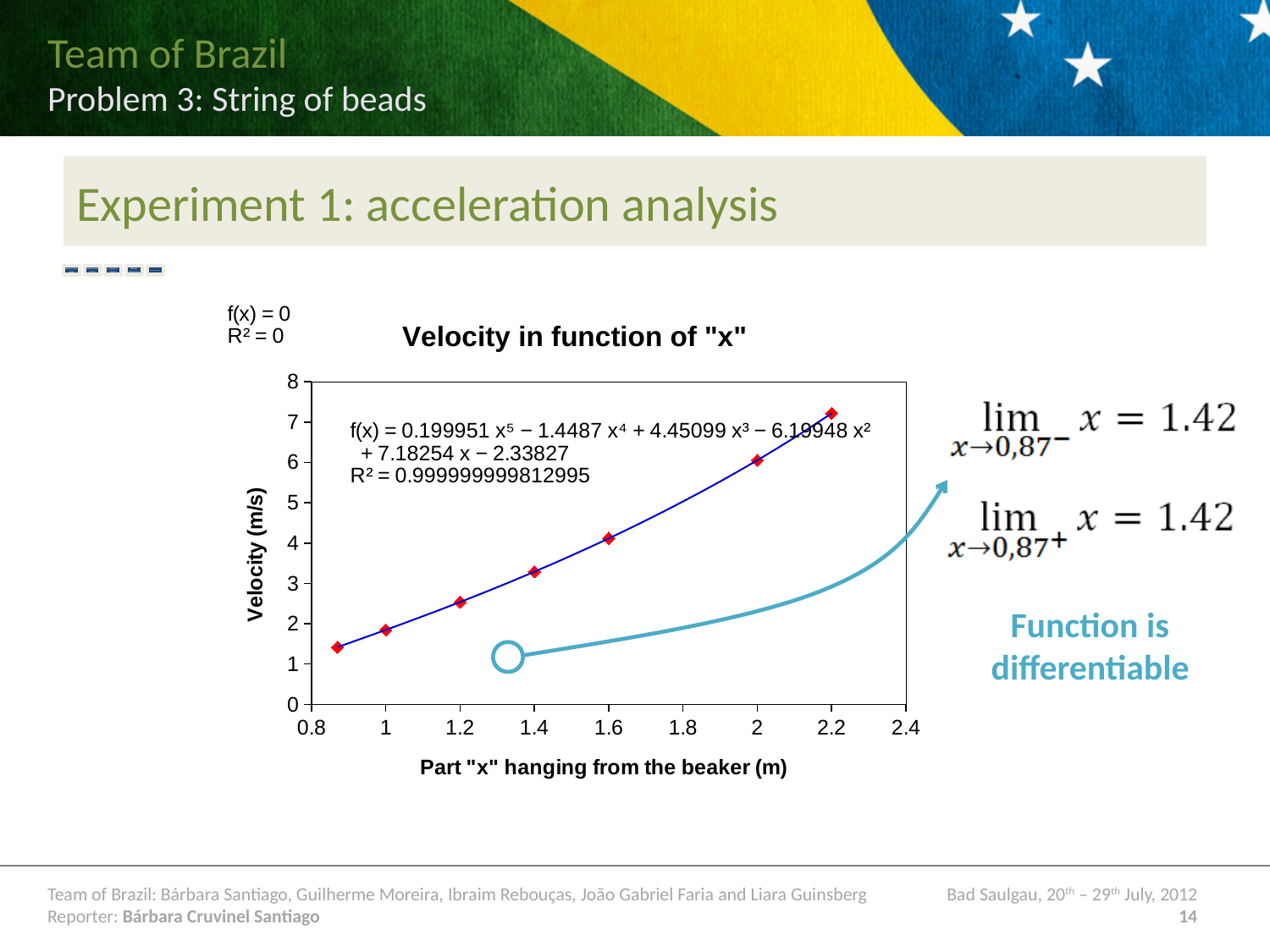
Is the velocity at x = 1.4 greater or less than 3 m/s? greater Which has the larger velocity: the point at x = 2 or the point at x = 1.6? x = 2 Is the velocity at x = 2.2 greater or less than 6 m/s? greater Is the velocity at x = 2 greater or less than 5 m/s? greater What is the title of the chart? Velocity in function of "x" Does velocity rise or fall as the part "x" hanging from the beaker increases? rise What kind of chart is shown on the slide? scatter chart with a fitted curve At which x value is the plotted velocity highest? 2.2 How many data points are plotted on the chart? 7 What is the label of the vertical axis? Velocity (m/s)